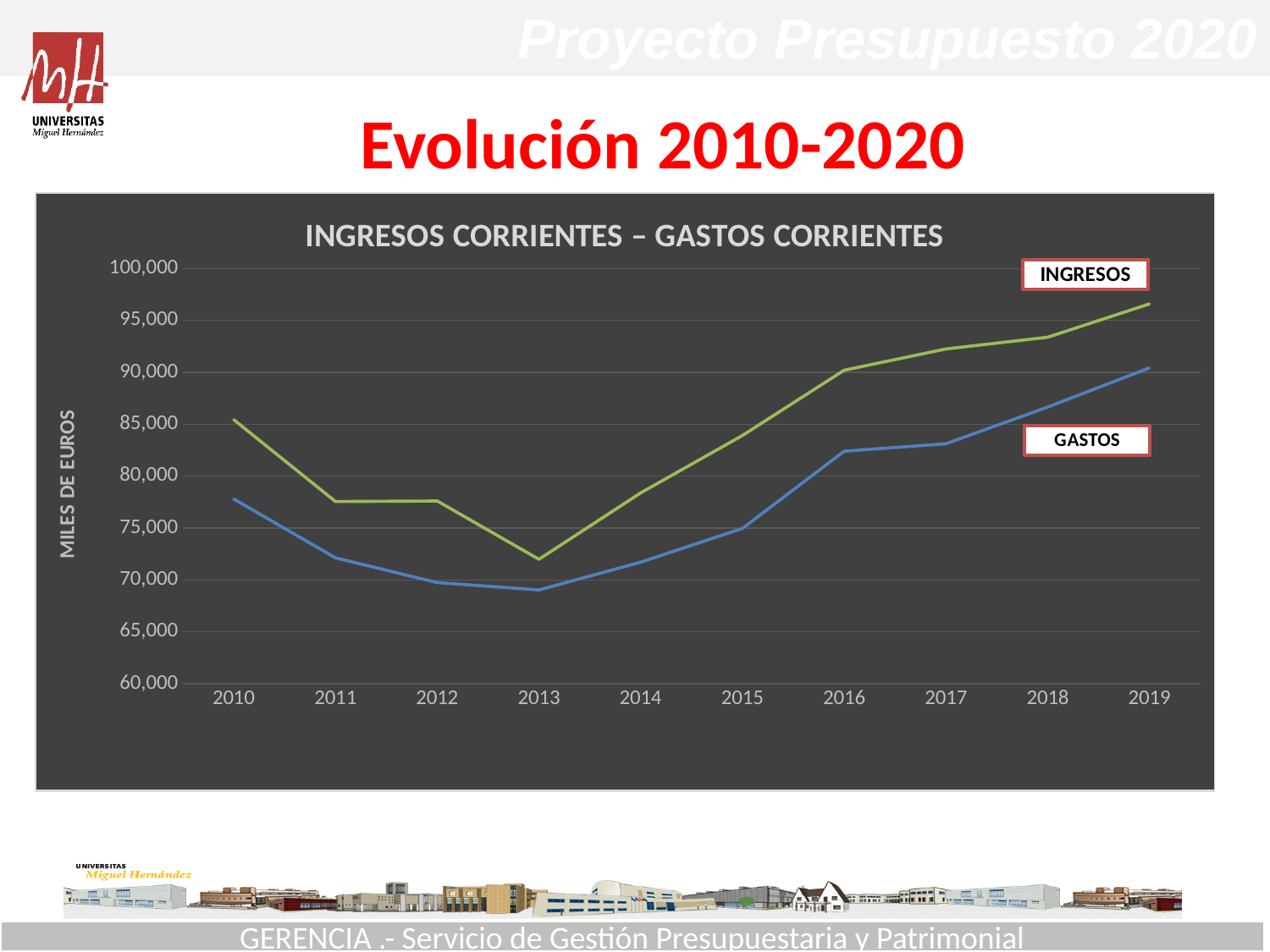
Do the INGRESOS values rise or fall from 2013 to 2019? rise What kind of chart is shown on the slide? line chart In which year is the INGRESOS line at its lowest? 2013 Is the value for GASTOS in 2010 greater or less than 80,000? less Is the value for GASTOS in 2013 greater or less than 70,000? less How many years are shown along the x axis of the chart? 10 In which year is the INGRESOS line at its highest? 2019 How many series are plotted on the chart? 2 What is the label on the vertical axis of the chart? MILES DE EUROS In which year is the GASTOS line at its lowest? 2013 Is the value for INGRESOS in 2019 greater or less than 95,000? greater Which series has the higher value in 2016, INGRESOS or GASTOS? INGRESOS